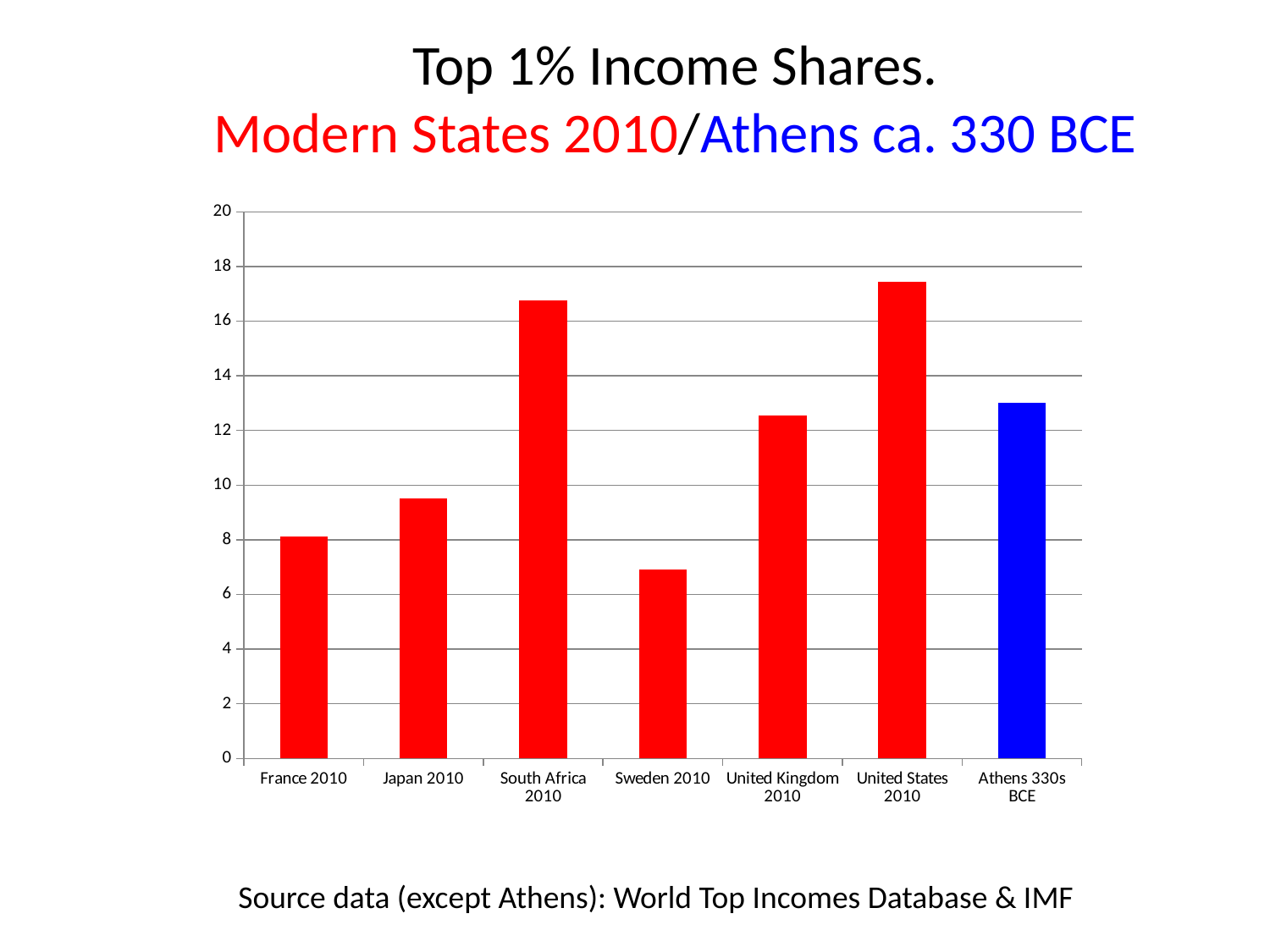
Is the value for South Africa 2010 greater or less than 16? greater Is the value for Japan 2010 greater or less than 10? less Is the value for Athens 330s BCE greater or less than 12? greater Which is larger, the value for South Africa 2010 or the value for Athens 330s BCE? South Africa 2010 Which category has the lowest top 1% income share in the chart? Sweden 2010 What colour is the bar for Athens 330s BCE? Blue Which is larger, the value for Japan 2010 or the value for France 2010? Japan 2010 What kind of chart is shown on the slide? Bar chart How many categories (bars) are shown in the chart? 7 Which category has the highest top 1% income share in the chart? United States 2010